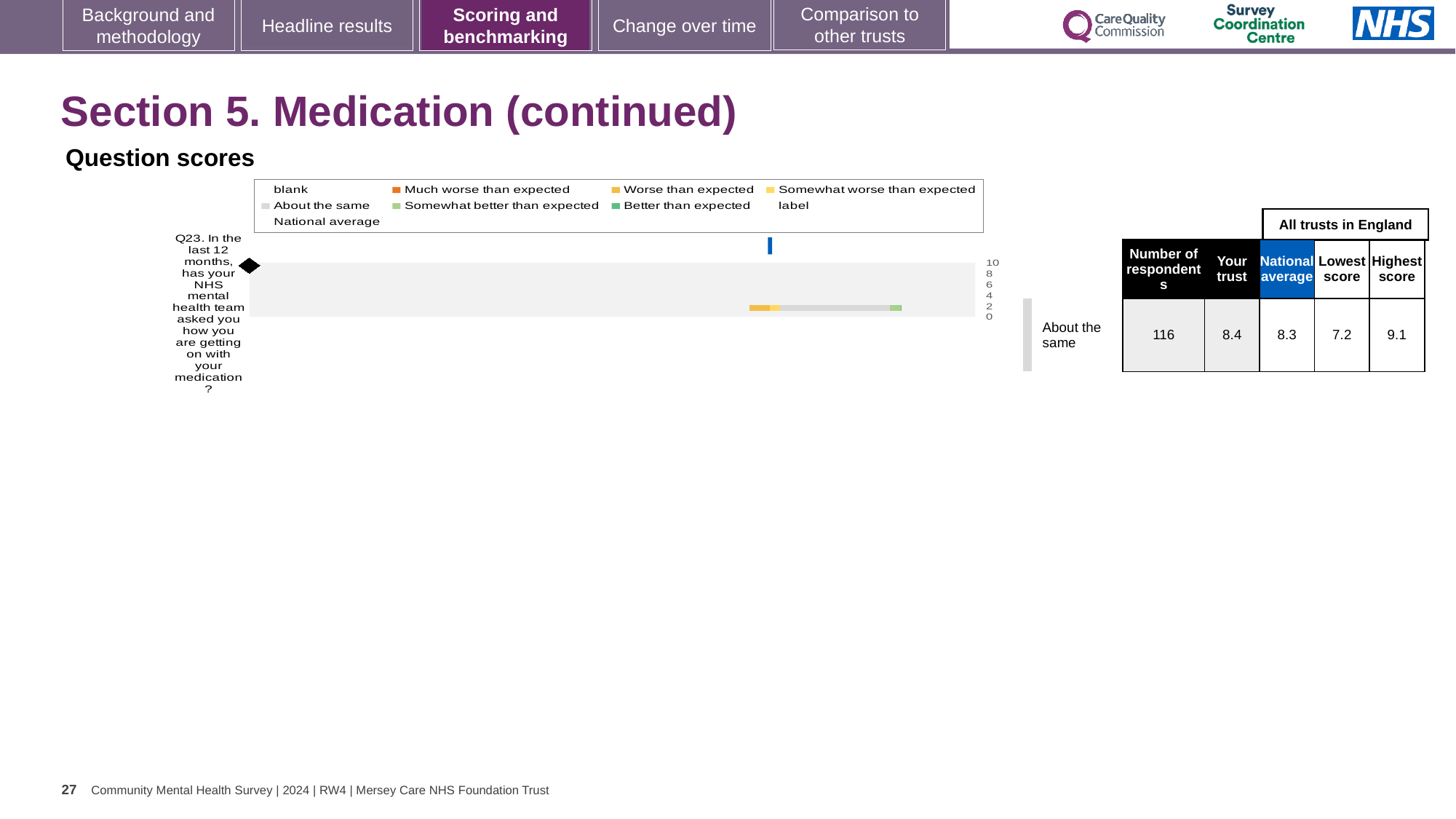
What is the national average score for Q23? 8.3 What is the difference between the highest score and the lowest score for Q23? 1.9 How many questions (categories) are plotted in the chart? 1 What is the 'Your trust' score for Q23? 8.4 How many respondents answered Q23? 116 What is the lowest score among all trusts in England for Q23? 7.2 What benchmark category is given for Q23? About the same What is the highest tick value shown on the chart's score axis? 10 What kind of chart is shown under 'Question scores'? bar chart What is the highest score among all trusts in England for Q23? 9.1 Which is larger for Q23, the 'Your trust' score or the national average? Your trust Which question is plotted in the chart? Q23. In the last 12 months, has your NHS mental health team asked you how you are getting on with your medication?